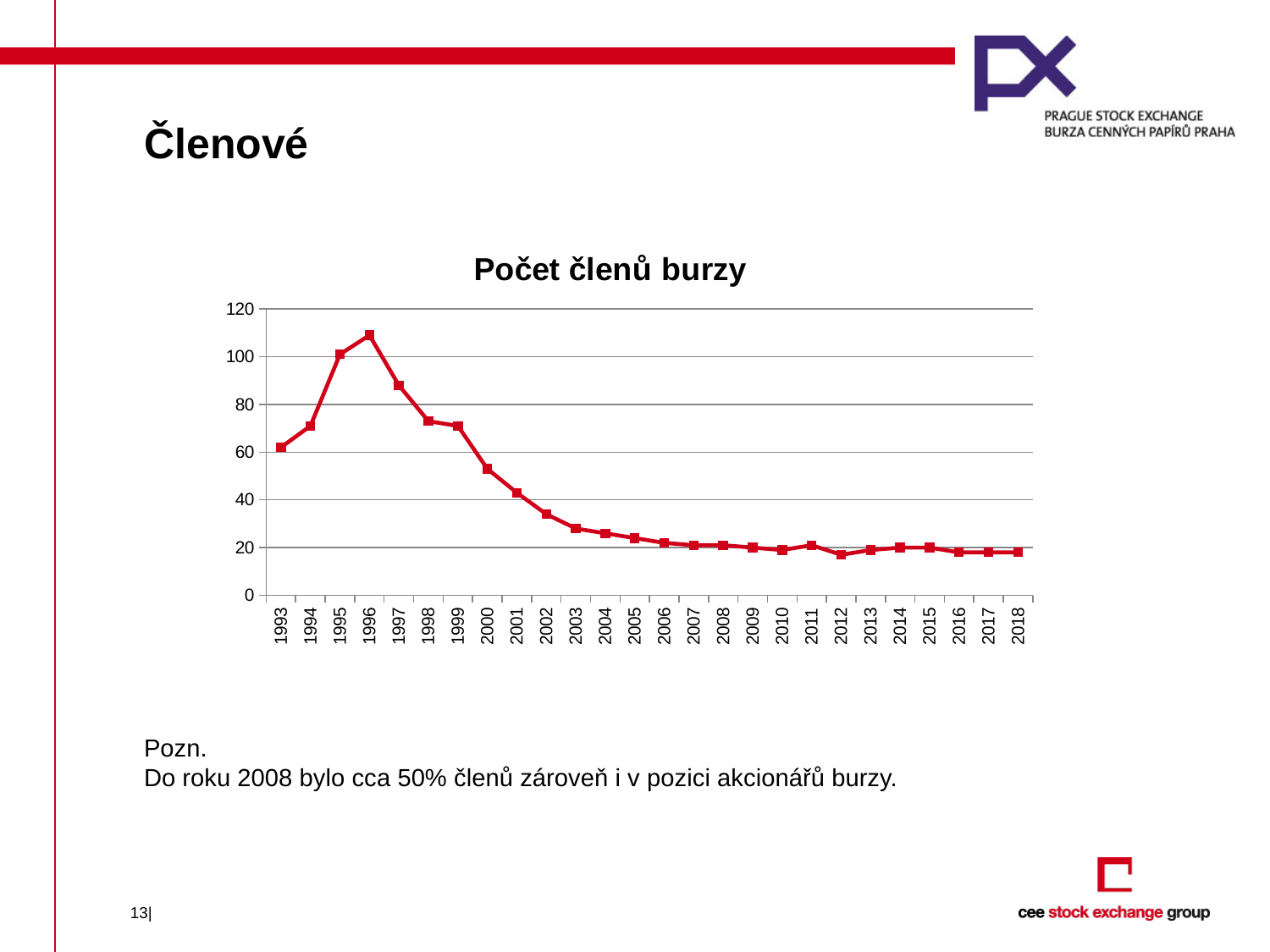
What is the title of the chart? Počet členů burzy Which year has the larger value, 1994 or 2000? 1994 How many years are plotted on the x axis of the chart? 26 Is the value for 2000 greater or less than 60? less Is the value for 2005 greater or less than 20? greater What kind of chart is shown on the slide? line chart In which year is the number of members highest? 1996 Which year has the larger value, 1995 or 1999? 1995 Is the value for 1997 greater or less than 80? greater Do the values rise or fall from 1996 to 2010? fall